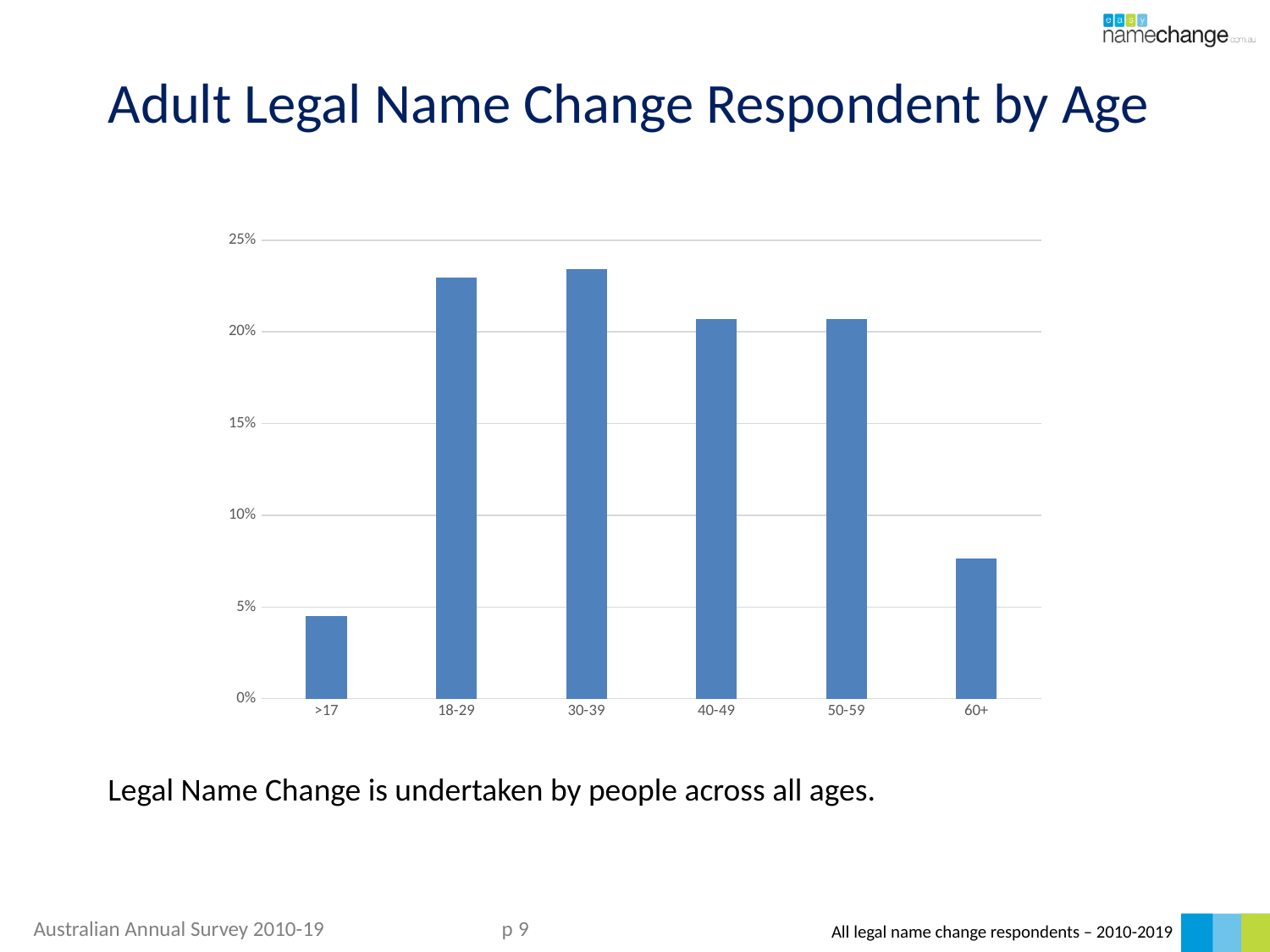
Is the value for 60+ greater or less than 5%? greater What is the title of the chart on the slide? Adult Legal Name Change Respondent by Age Is the value for 30-39 greater or less than 25%? less Is the value for 60+ greater or less than 10%? less Which has the larger value, >17 or 60+? 60+ Which has the larger value, 18-29 or 60+? 18-29 What kind of chart is shown on the slide? bar chart Which has the larger value, 30-39 or 40-49? 30-39 How many age categories are shown on the x axis of the chart? 6 Which age category has the lowest value in the chart? >17